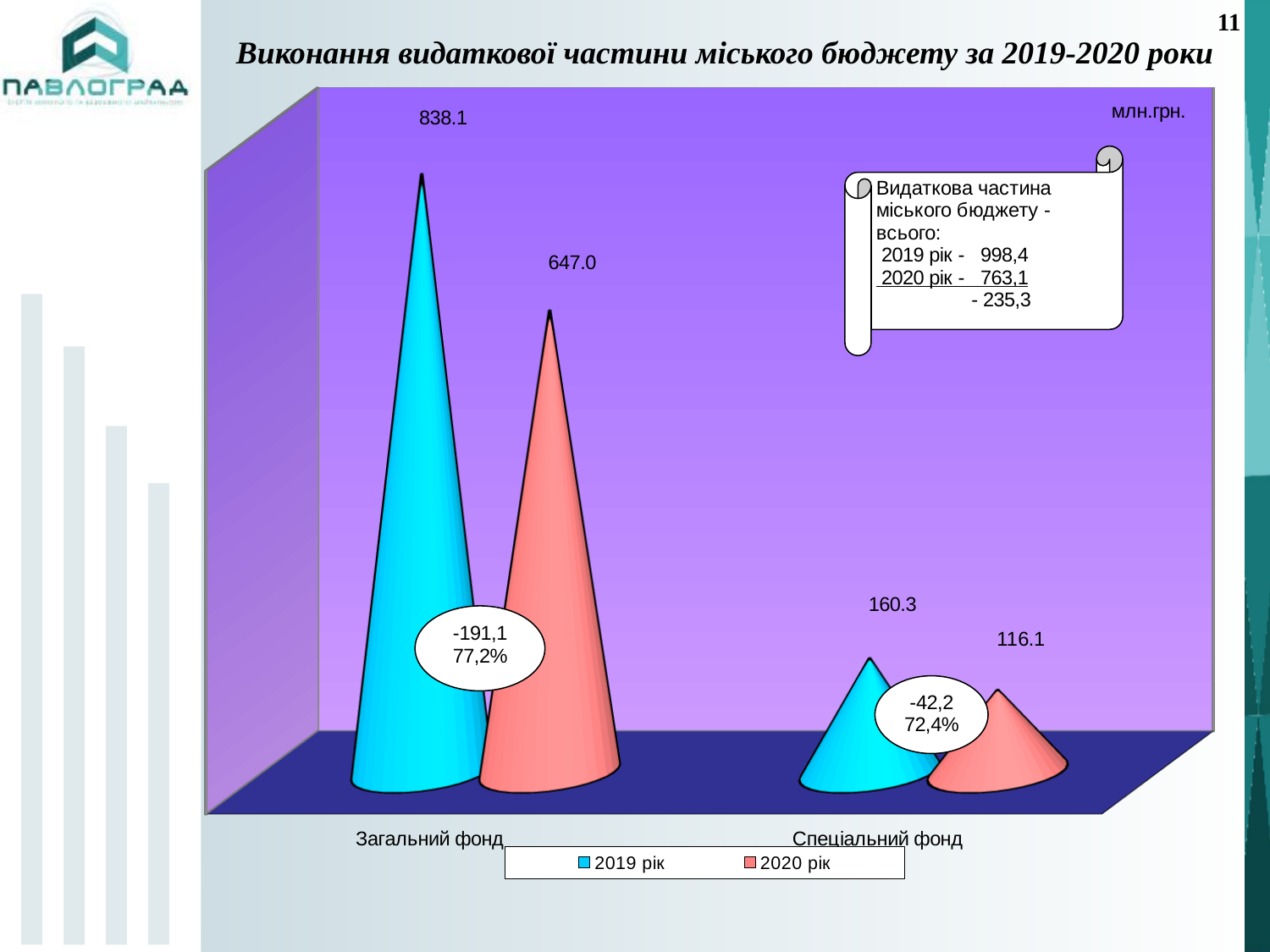
What is the value for 2019 рік in the Спеціальний фонд category? 160.3 How many series does the chart legend list? 2 What is the difference between the 2019 рік and 2020 рік values for Загальний фонд? 191.1 How many categories are shown on the x axis of the chart? 2 Which category has the lowest value for 2020 рік? Спеціальний фонд What is the difference between the 2019 рік values for Загальний фонд and Спеціальний фонд? 677.8 Which is larger for Спеціальний фонд: the 2019 рік value or the 2020 рік value? 2019 рік What is the value for 2020 рік in the Спеціальний фонд category? 116.1 What is the title of the chart on the slide? Виконання видаткової частини міського бюджету за 2019-2020 роки What is the value for 2020 рік in the Загальний фонд category? 647.0 What is the value for 2019 рік in the Загальний фонд category? 838.1 Which category has the highest value for 2019 рік? Загальний фонд